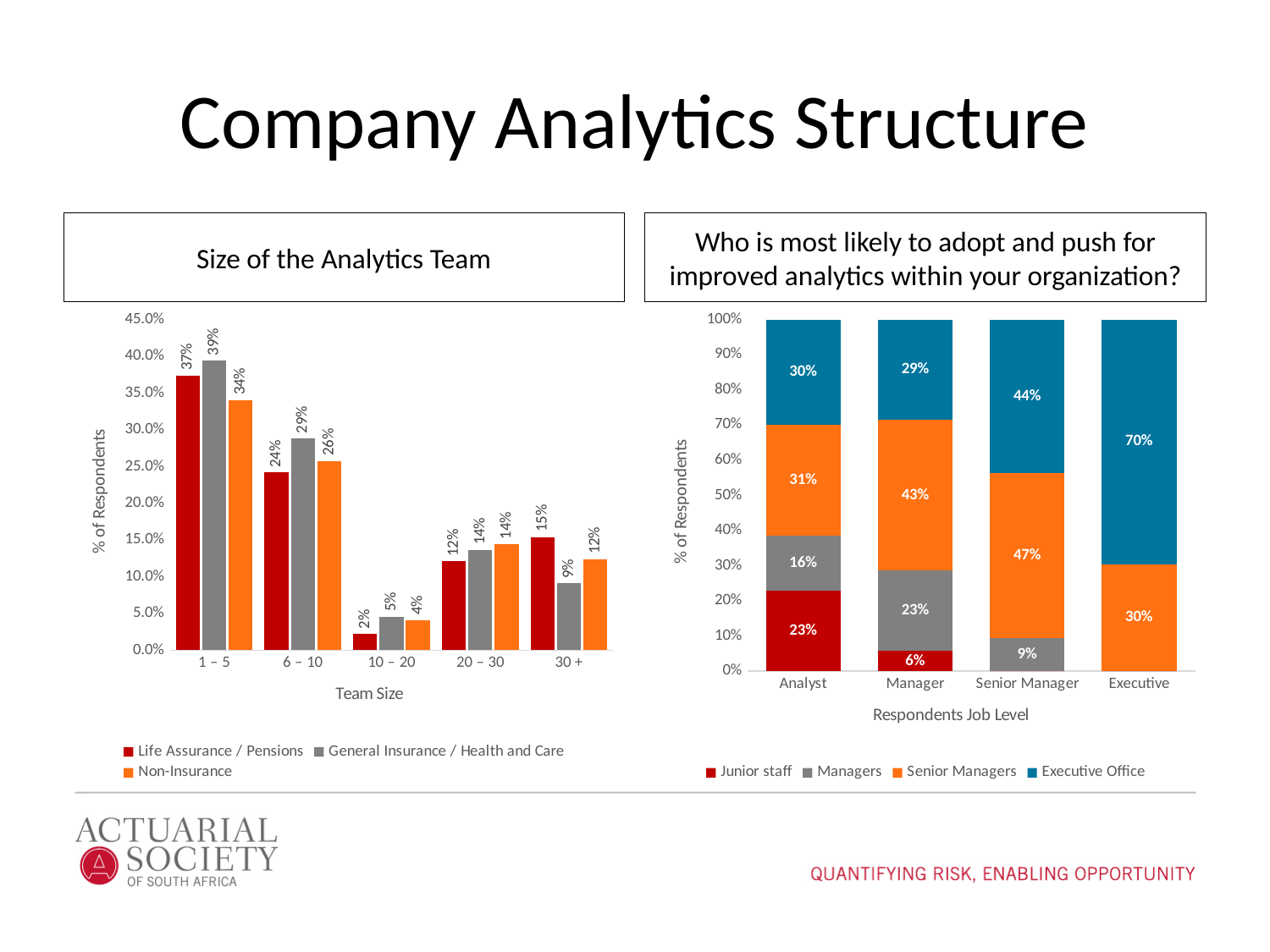
In the 'Size of the Analytics Team' chart, what is the value for Life Assurance / Pensions in the 1 – 5 team size category? 37% How many team size categories are shown on the x axis of the 'Size of the Analytics Team' chart? 5 In the 'Who is most likely to adopt and push for improved analytics within your organization?' chart, what is the Senior Managers value for the Manager job level? 43% In the 'Size of the Analytics Team' chart, which team size category has the lowest value for Life Assurance / Pensions? 10 – 20 In the 'Size of the Analytics Team' chart, which is larger for the 30 + category: Life Assurance / Pensions or General Insurance / Health and Care? Life Assurance / Pensions What is the x-axis title of the 'Who is most likely to adopt and push for improved analytics within your organization?' chart? Respondents Job Level What type of chart is the 'Who is most likely to adopt and push for improved analytics within your organization?' chart? Stacked bar chart How many series does the legend of the 'Size of the Analytics Team' chart list? 3 In the 'Size of the Analytics Team' chart, what is the difference between the Non-Insurance values for the 1 – 5 and 30 + categories? 22% In the 'Size of the Analytics Team' chart, what is the value for General Insurance / Health and Care in the 6 – 10 team size category? 29% In the 'Who is most likely to adopt and push for improved analytics within your organization?' chart, what is the difference between the Junior staff values for Analyst and Manager? 17% In the 'Who is most likely to adopt and push for improved analytics within your organization?' chart, which job level has the highest Executive Office value? Executive